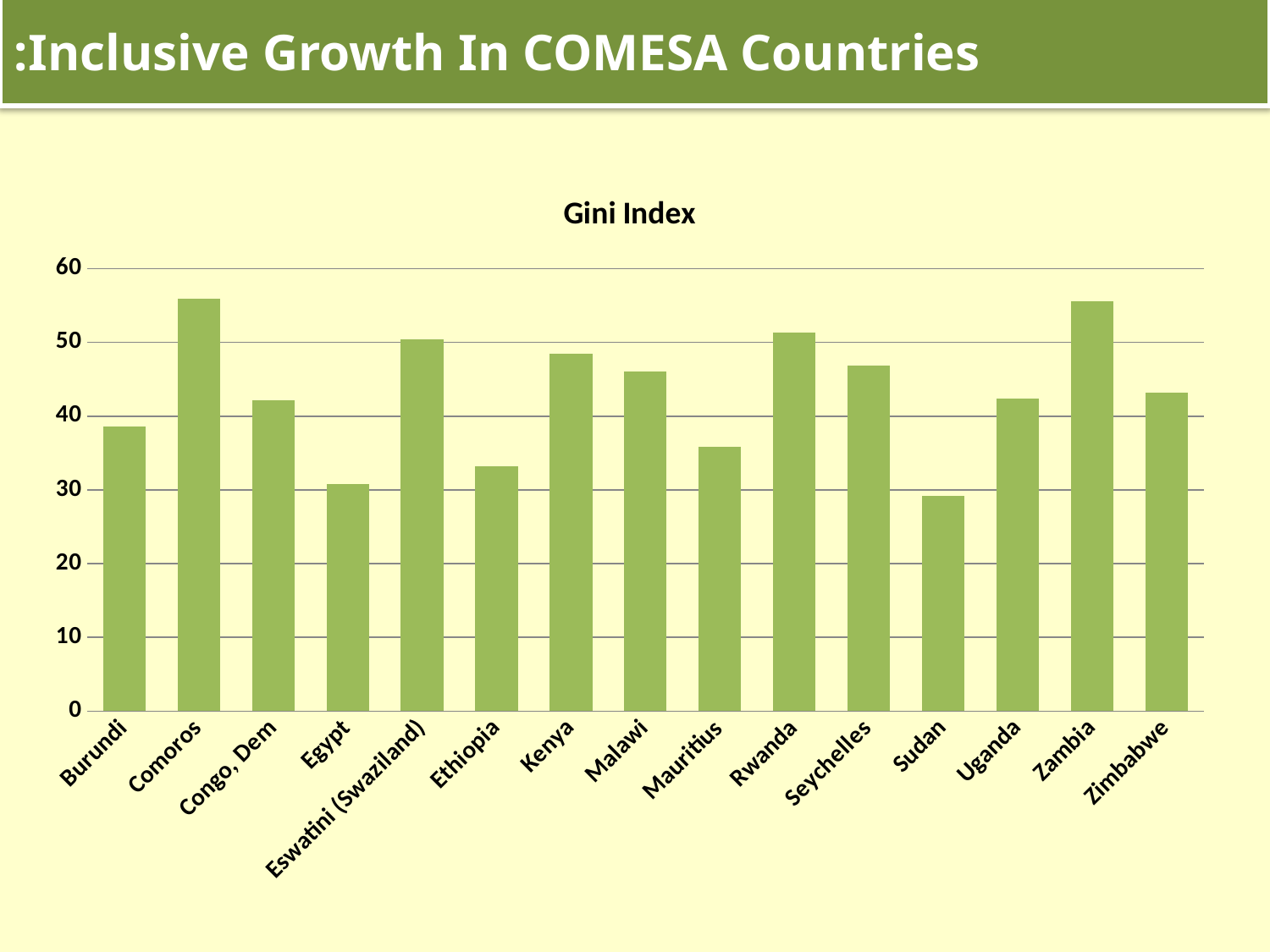
Is the Gini Index value for Ethiopia greater or less than 30? greater Which has a higher Gini Index, Kenya or Mauritius? Kenya Which has a higher Gini Index, Comoros or Egypt? Comoros Is the Gini Index value for Comoros greater or less than 50? greater Is the Gini Index value for Egypt greater or less than 40? less How many countries are shown on the x axis of the chart? 15 Which has a higher Gini Index, Rwanda or Uganda? Rwanda Which country has the lowest Gini Index in the chart? Sudan What type of chart is shown on the slide? bar chart What is the title of the chart? Gini Index